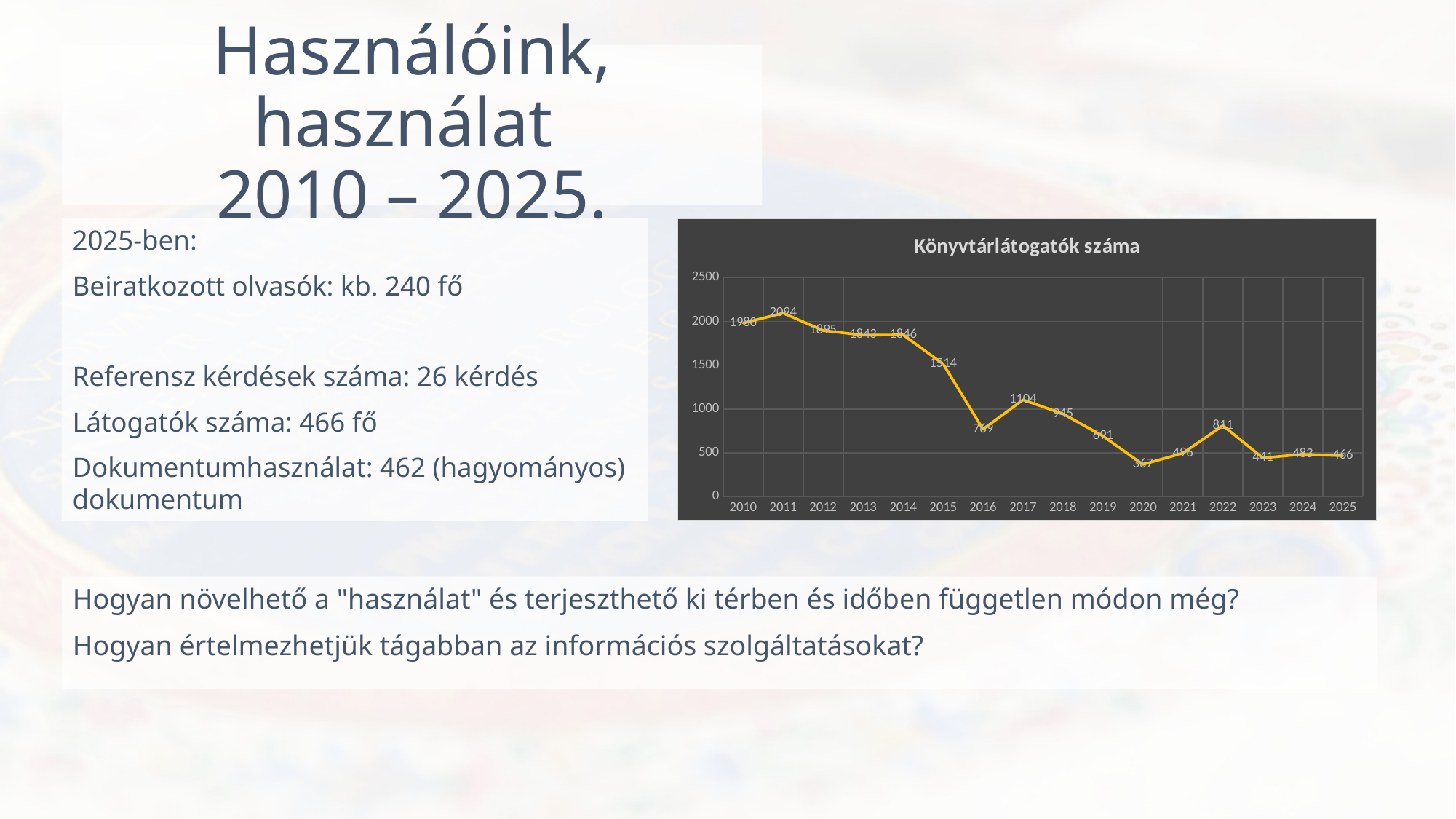
What is the number of library visitors in 2015 according to the chart? 1514 Which year has the highest number of library visitors in the chart? 2011 Which year had more library visitors, 2017 or 2022? 2017 How many years are plotted on the x axis of the chart? 16 What is the number of library visitors in 2025 according to the chart? 466 Overall, do the values in the chart rise or fall from 2010 to 2025? fall What is the difference between the number of visitors in 2011 and in 2020? 1727 Which year has the lowest number of library visitors in the chart? 2020 What is the title of the chart? Könyvtárlátogatók száma What is the number of library visitors in 2011 according to the chart? 2094 What kind of chart is shown on the slide? line chart What is the number of library visitors in 2020 according to the chart? 367